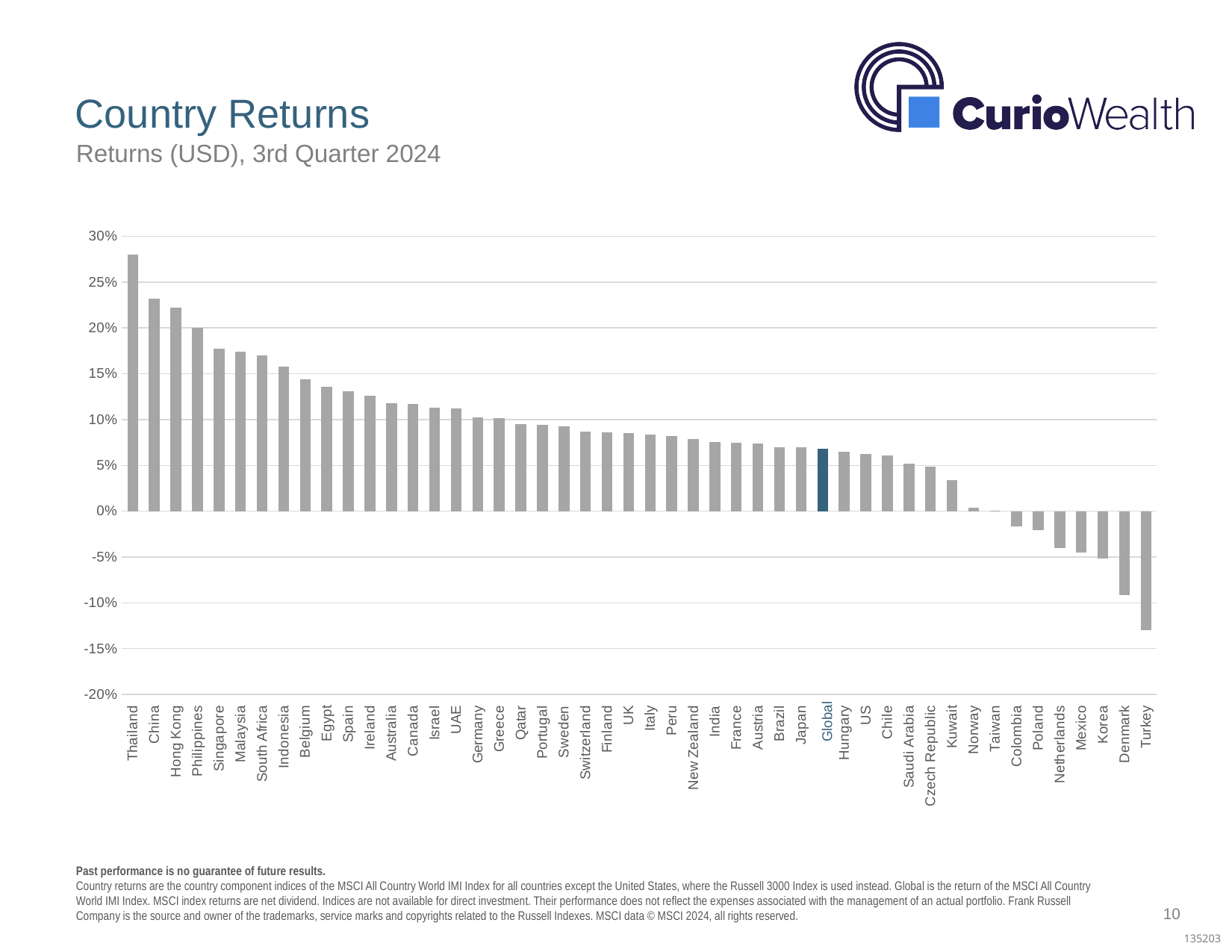
Is the value for Thailand greater or less than 25%? greater Is the value for Turkey greater or less than -10%? less What kind of chart is shown on the slide? bar chart Do the values generally rise or fall moving from left to right along the x axis? fall Which country has the highest return in the chart? Thailand Is the value for Kuwait greater or less than 5%? less How many bars (countries plus Global) are plotted in the chart? 48 Which has the larger return, Thailand or China? Thailand Which country has the lowest return in the chart? Turkey Which bar is shown in a different colour (dark blue) from the rest? Global